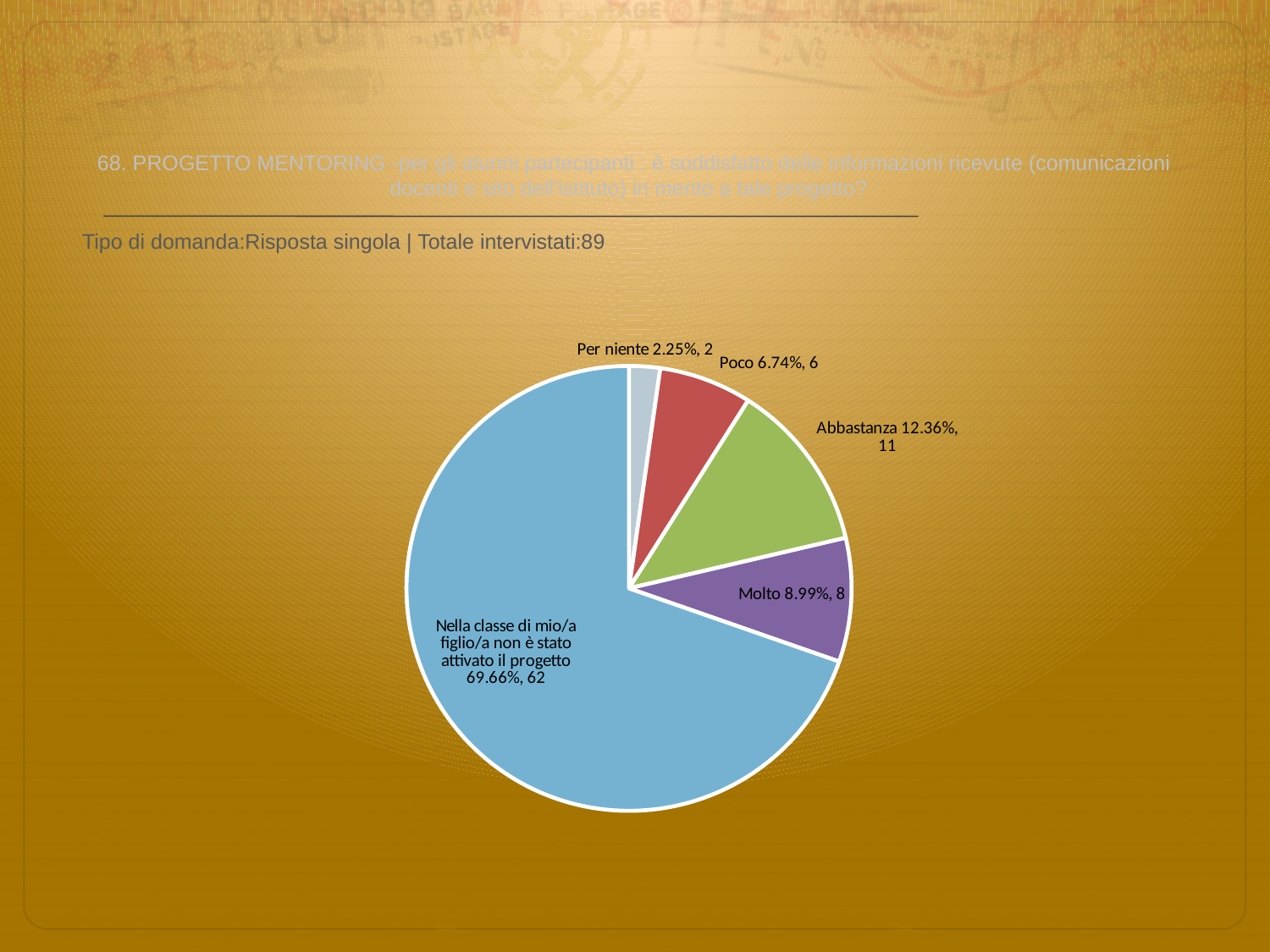
What percentage is shown for the 'Molto' slice? 8.99% What share of the pie does the 'Nella classe di mio/a figlio/a non è stato attivato il progetto' slice represent? 69.66% Which category has the largest slice of the pie? Nella classe di mio/a figlio/a non è stato attivato il progetto What kind of chart is shown on the slide? pie chart What is the total number of respondents stated on the slide? 89 Which has more respondents, 'Poco' or 'Molto'? Molto How many respondents answered 'Abbastanza'? 11 What is the difference in respondent count between 'Abbastanza' and 'Molto'? 3 How many slices does the pie chart have? 5 Which category has the smallest slice of the pie? Per niente How many respondents answered 'Per niente'? 2 What percentage is shown for the 'Poco' slice? 6.74%